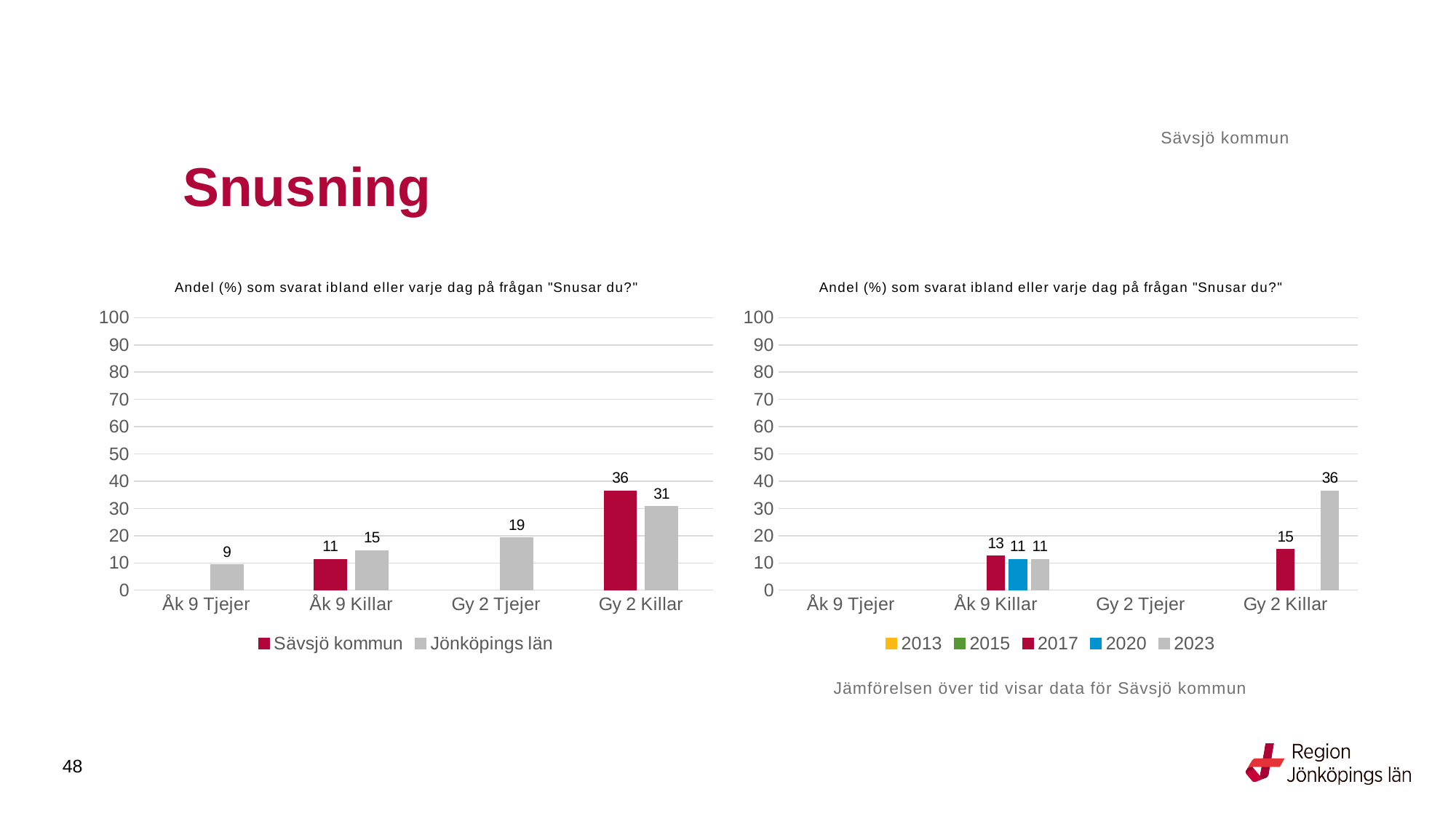
In the left chart, for Åk 9 Killar, which is larger: Sävsjö kommun or Jönköpings län? Jönköpings län In the left chart, what is the value for Sävsjö kommun for Åk 9 Killar? 11 In the left chart, which category has the highest value for Jönköpings län? Gy 2 Killar In the left chart, what is the difference between Sävsjö kommun and Jönköpings län for Gy 2 Killar? 5 In the right chart, what is the value for 2023 for Åk 9 Killar? 11 In the right chart, what is the value for 2017 for Gy 2 Killar? 15 In the left chart, what is the value for Jönköpings län for Gy 2 Tjejer? 19 In the left chart, what is the value for Jönköpings län for Gy 2 Killar? 31 What kind of chart is the left chart? Bar chart In the left chart, how many series does the legend list? 2 In the right chart, how many series does the legend list? 5 In the right chart, what is the difference between 2023 and 2017 for Gy 2 Killar? 21